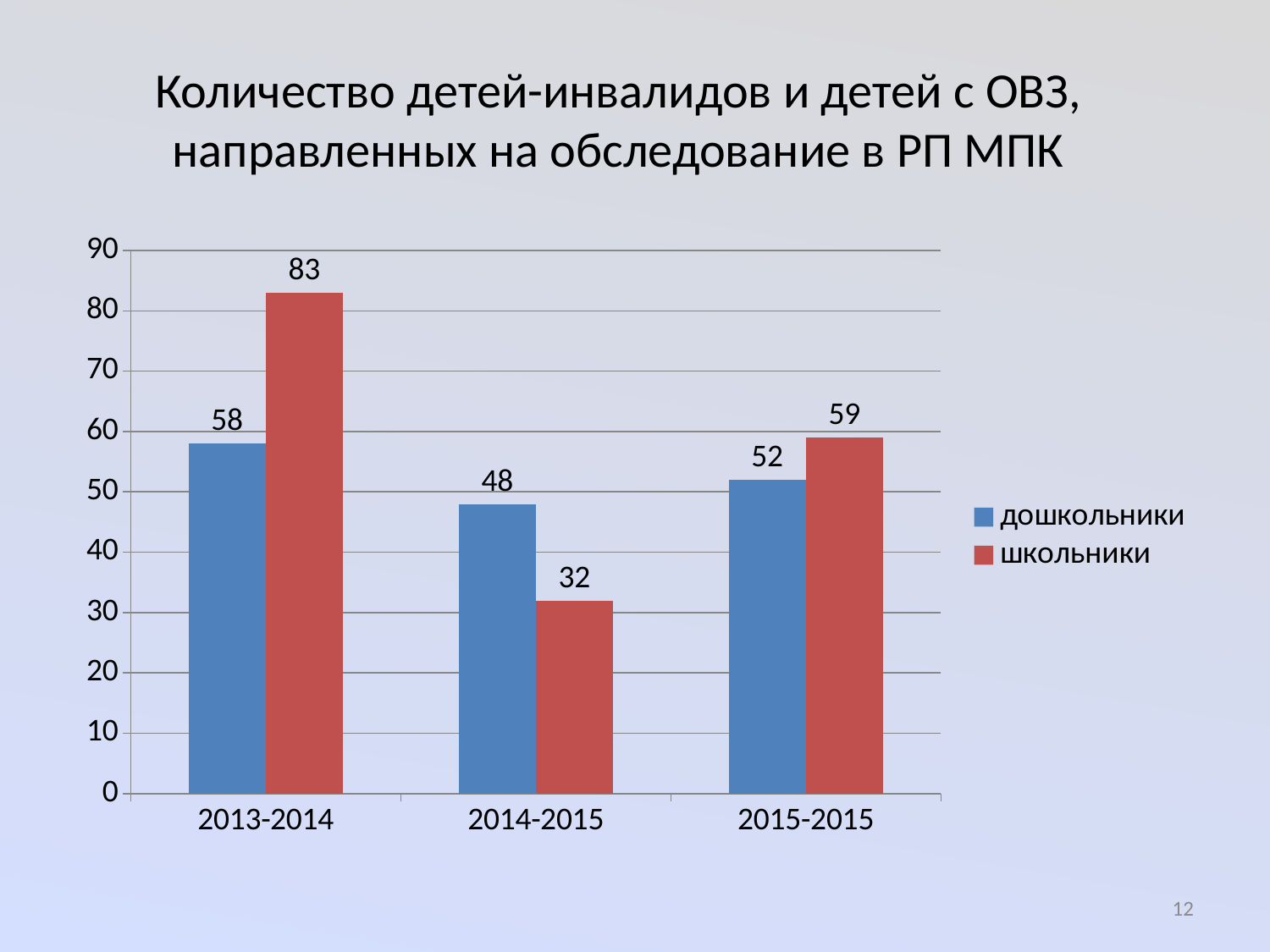
Which period has the lowest value for дошкольники? 2014-2015 Which colour represents школьники in the legend? red What is the value for школьники in 2014-2015? 32 Which is larger in 2014-2015, дошкольники or школьники? дошкольники What kind of chart is shown on the slide? bar chart How many series does the legend list? 2 What is the difference between школьники and дошкольники in 2013-2014? 25 How many periods are shown on the x axis? 3 What is the value for дошкольники in 2013-2014? 58 Is the value for школьники in 2013-2014 greater or less than 80? greater Which period has the highest value for школьники? 2013-2014 What is the value for школьники in 2015-2015? 59